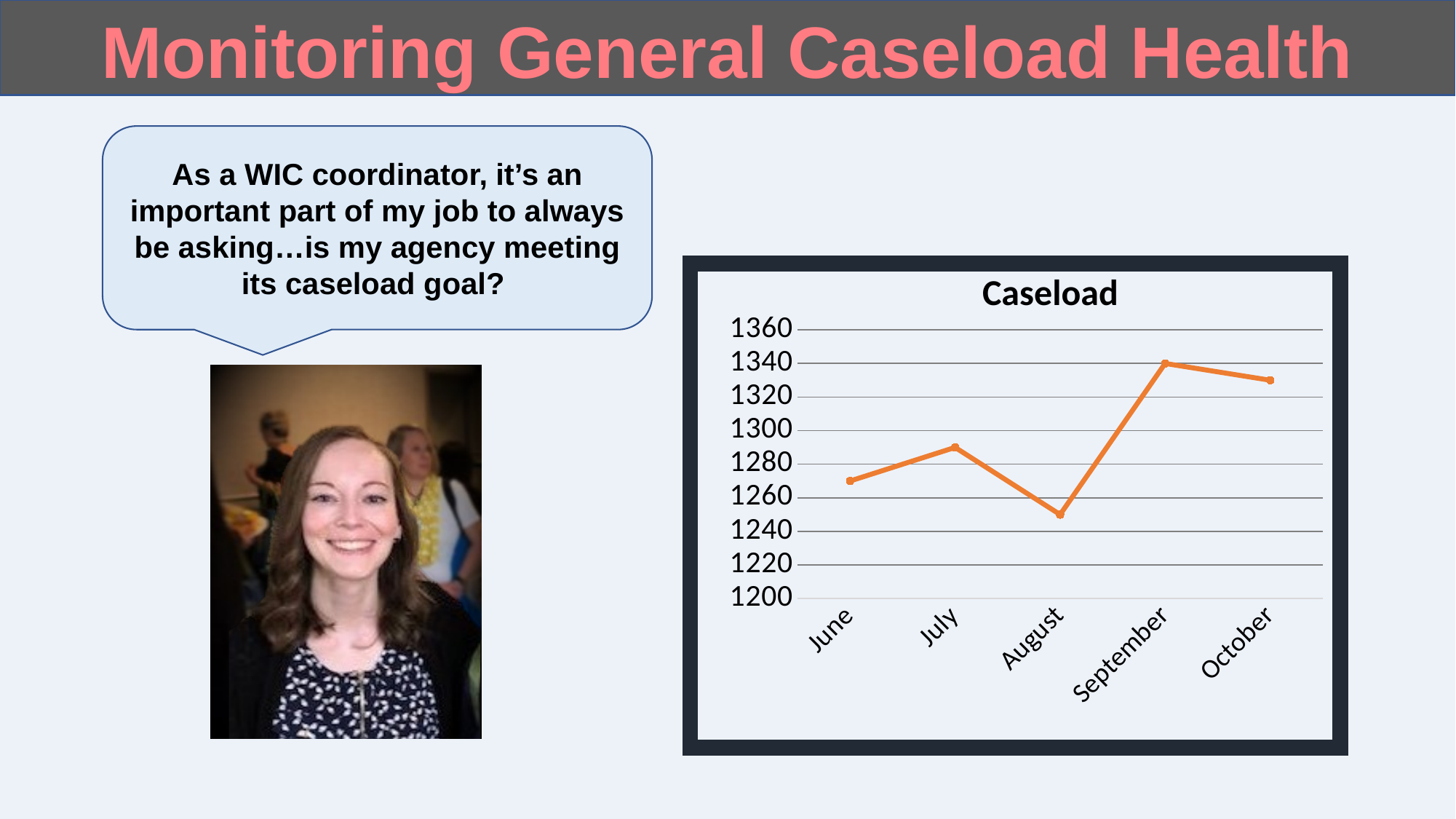
How many months are plotted on the x axis of the chart? 5 Is the caseload for August greater or less than 1260? less What is the caseload value for September? 1340 Does the caseload rise or fall from July to August? fall Which month has the lowest caseload? August What kind of chart is shown on the slide? line chart What is the title of the chart? Caseload Which month has the larger caseload, June or July? July Is the caseload for July greater or less than 1300? less Which month has the highest caseload? September Is the caseload for October greater or less than 1320? greater